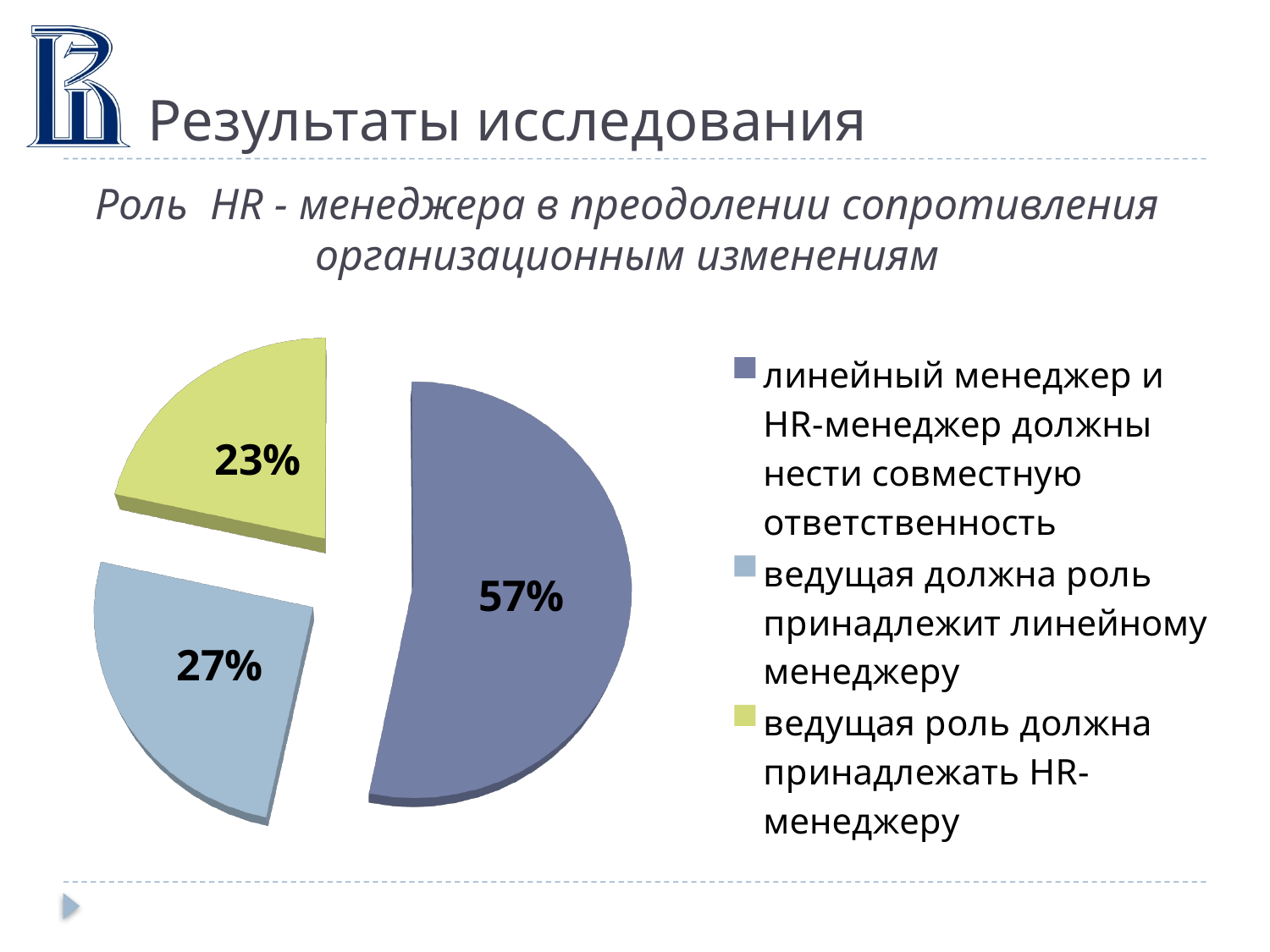
Which category has the largest slice of the pie? линейный менеджер и HR-менеджер должны нести совместную ответственность What is the difference between the 27% slice and the 23% slice? 4% What share of the pie corresponds to 'линейный менеджер и HR-менеджер должны нести совместную ответственность'? 57% Which is larger: the share for 'ведущая должна роль принадлежит линейному менеджеру' or the share for 'ведущая роль должна принадлежать HR-менеджеру'? ведущая должна роль принадлежит линейному менеджеру How many slices does the pie chart have? 3 What share of the pie corresponds to 'ведущая роль должна принадлежать HR-менеджеру'? 23% Which category has the smallest slice of the pie? ведущая роль должна принадлежать HR-менеджеру What is the difference between the largest slice (57%) and the smallest slice (23%)? 34% What kind of chart is shown on the slide? pie chart What colour is the slice labelled 23%? yellow-green How many entries does the legend list? 3 What share of the pie corresponds to 'ведущая должна роль принадлежит линейному менеджеру'? 27%